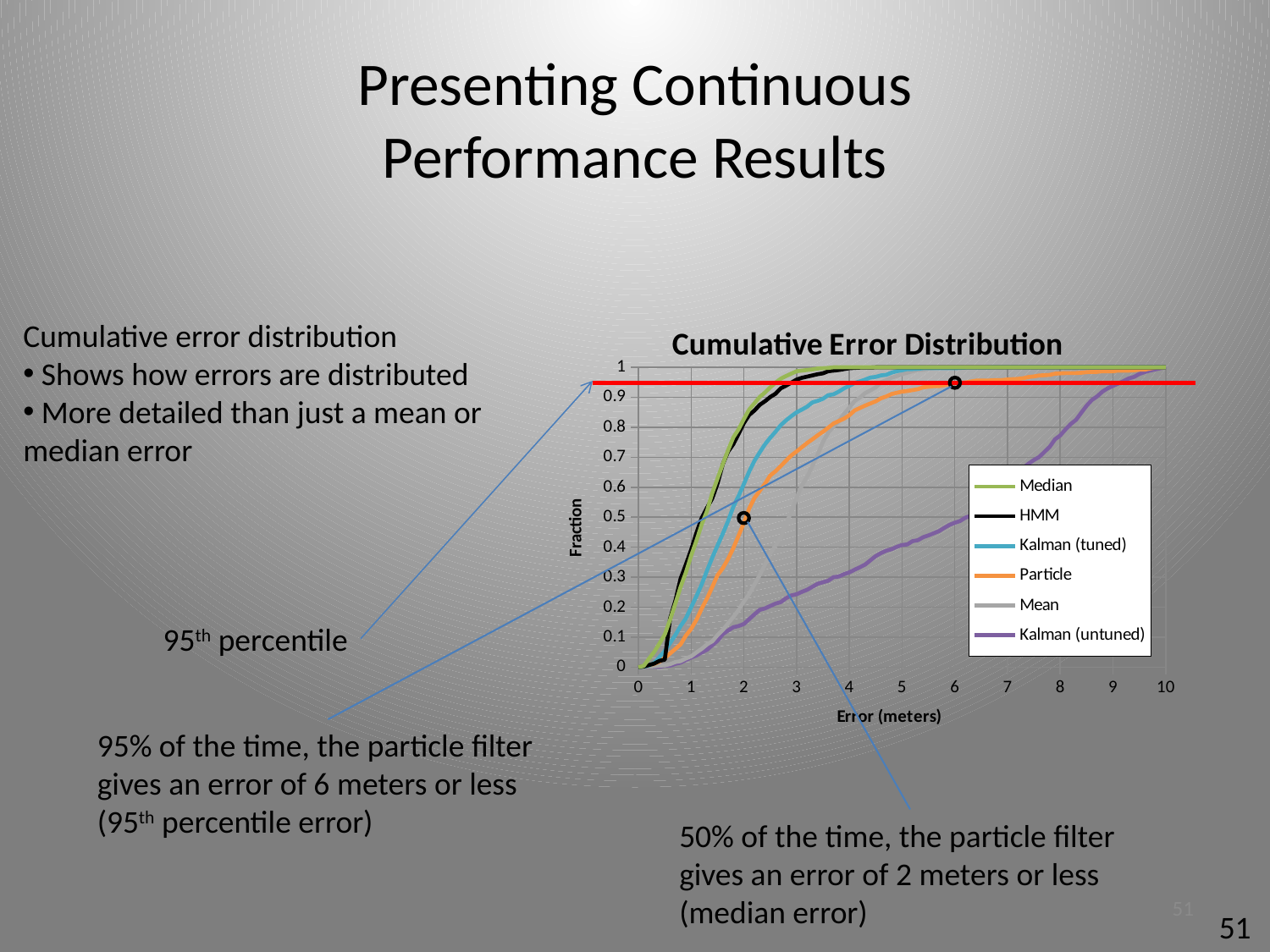
According to the slide, at what error (in meters) does the Particle curve reach a fraction of 0.95? 6 How many series does the chart legend list? 6 Is the value of the Kalman (untuned) curve at an error of 5 meters greater or less than 0.5? less What is the title of the chart? Cumulative Error Distribution Do the curves rise or fall as the error increases along the x axis? Rise According to the slide, at what error (in meters) does the Particle curve reach a fraction of 0.5? 2 Is the value of the Median curve at an error of 2 meters greater or less than 0.7? greater Is the value of the Kalman (tuned) curve at an error of 3 meters greater or less than 0.7? greater What type of chart is shown on the slide? Line chart Which series has the lowest fraction at an error of 5 meters? Kalman (untuned) At an error of 5 meters, which curve is higher: Particle or Kalman (untuned)? Particle What is the label of the x axis of the chart? Error (meters)